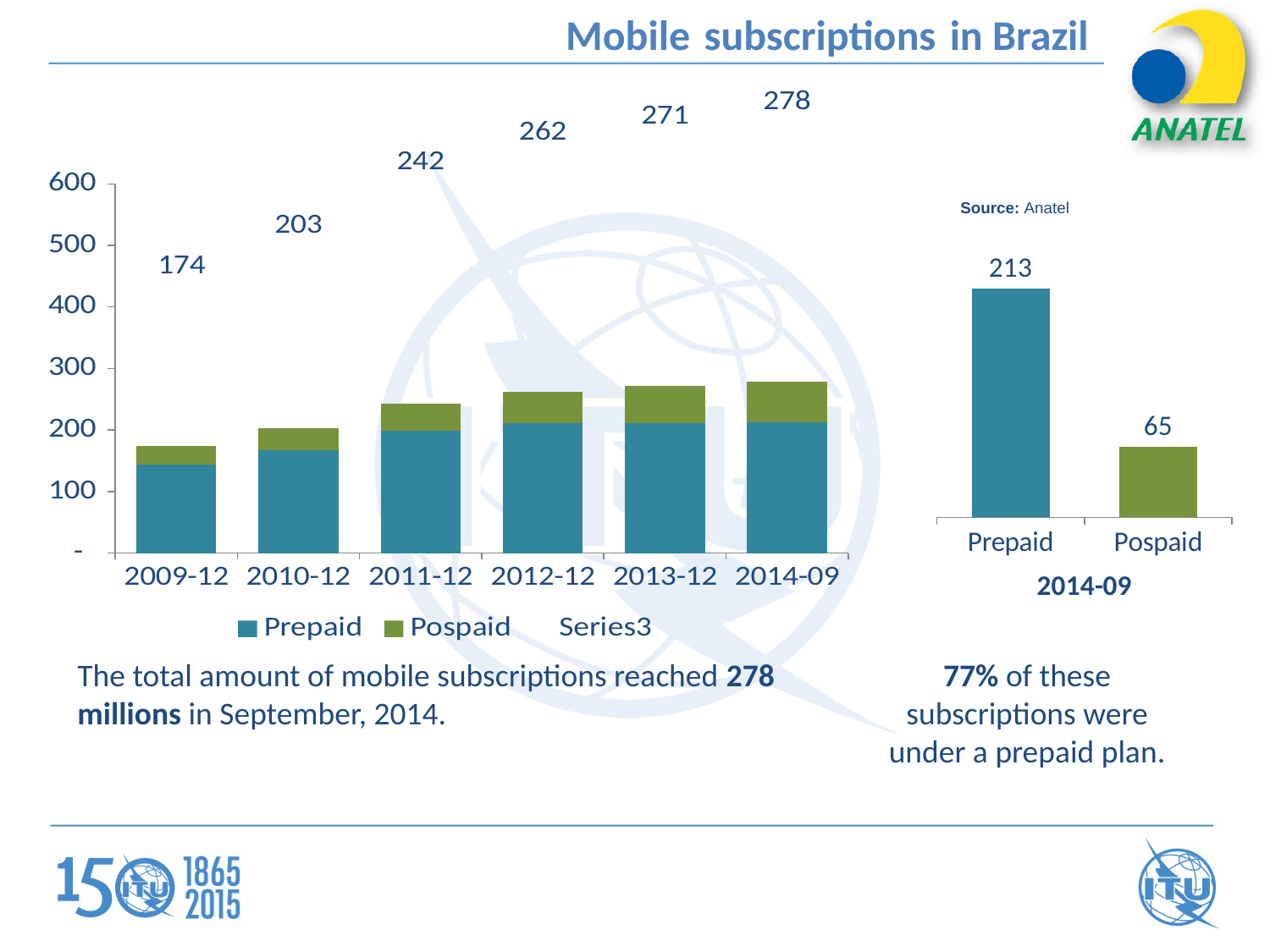
What kind of chart is the right chart for 2014-09? bar chart In the right chart for 2014-09, what is the value for Prepaid? 213 In the right chart for 2014-09, what is the difference between Prepaid and Pospaid? 148 In the left stacked bar chart, what is the total labelled for 2011-12? 242 How many entries does the legend of the left chart list? 3 In the left stacked bar chart, what is the total labelled for 2009-12? 174 In the left stacked bar chart, is the Prepaid value for 2009-12 greater or less than 200? less How many periods are shown on the x axis of the left stacked bar chart? 6 In the left stacked bar chart, which period has the highest total? 2014-09 In the left stacked bar chart, what is the total labelled for 2014-09? 278 In the left stacked bar chart, do the totals rise or fall from 2009-12 to 2014-09? rise In the left stacked bar chart, what is the difference between the totals for 2014-09 and 2009-12? 104